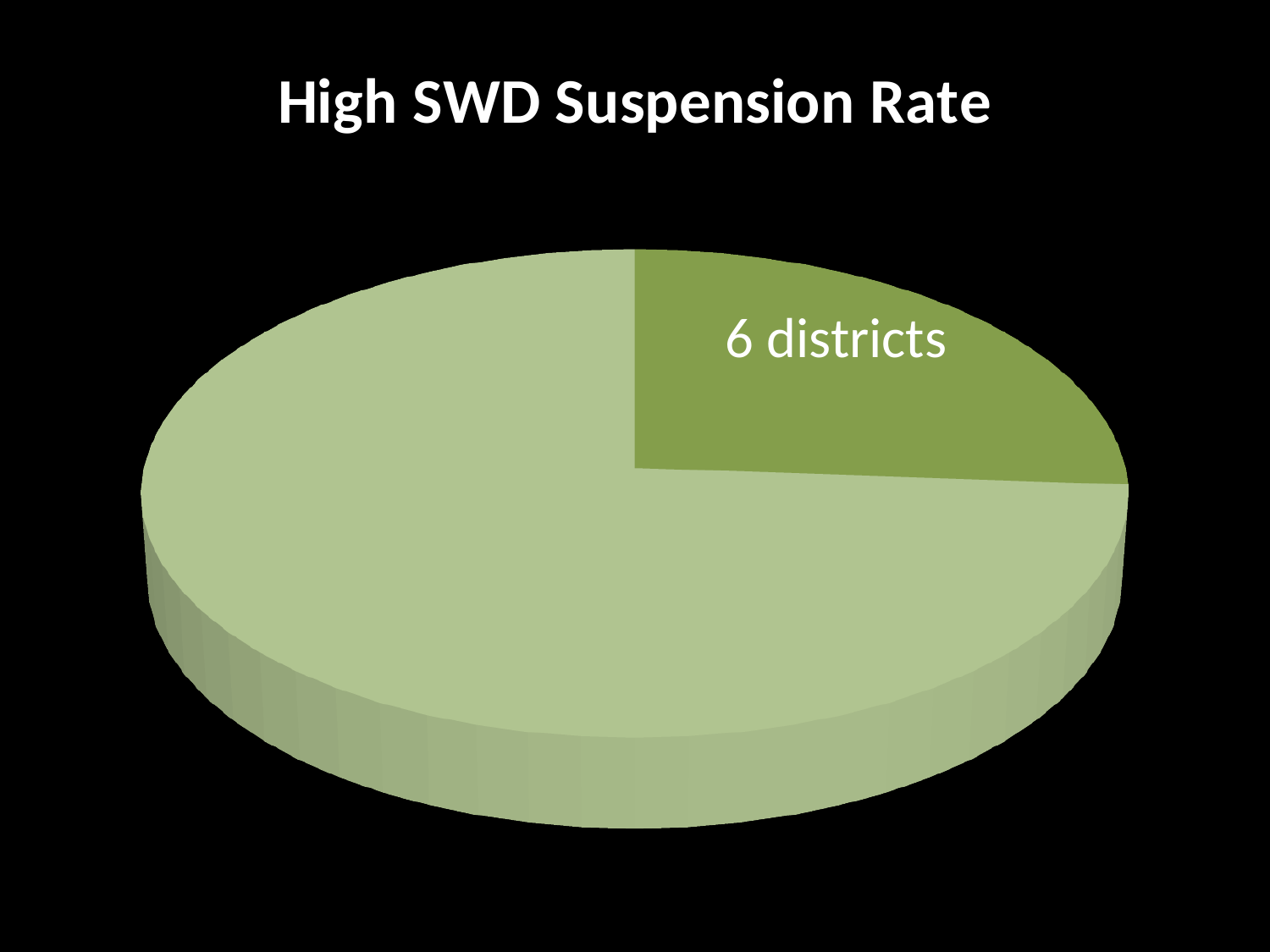
What is the title of the chart? High SWD Suspension Rate Which slice is larger: the darker green slice labeled "6 districts" or the lighter green unlabeled slice? the lighter green unlabeled slice How many slices does the pie chart have? 2 Which slice of the pie is the smallest? the slice labeled "6 districts" What label is printed on the smaller, darker green slice of the pie? 6 districts Is the slice labeled "6 districts" more or less than half of the pie? less What kind of chart is shown on the slide? pie chart Does the chart include a legend? No